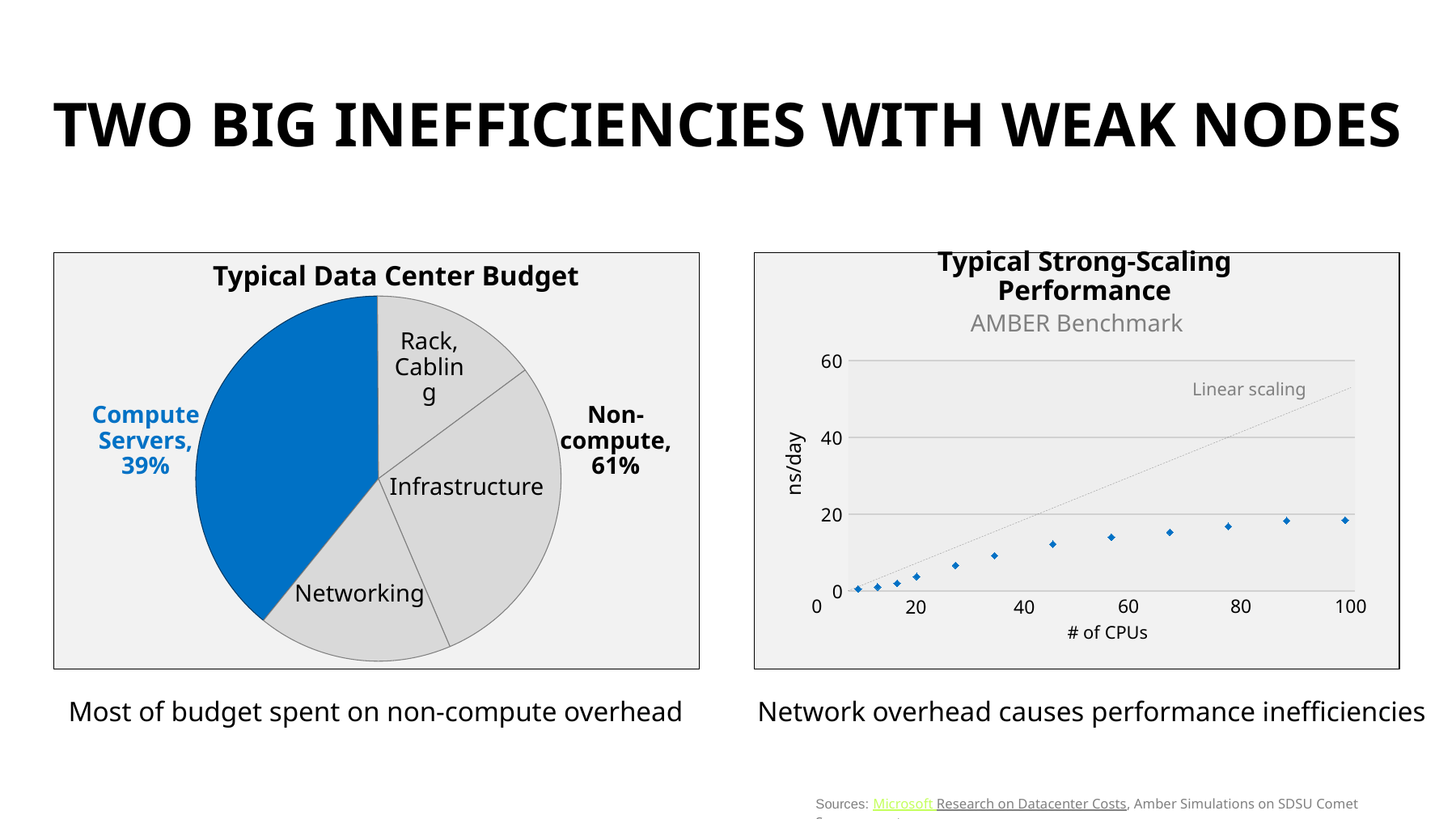
Which slice is the largest in the Typical Data Center Budget pie chart? Compute Servers What kind of chart is the Typical Data Center Budget chart? Pie chart In the Typical Data Center Budget pie chart, which slice is coloured blue? Compute Servers How many data points are plotted in the Typical Strong-Scaling Performance chart? 12 In the Typical Strong-Scaling Performance chart, what is the dashed reference line labelled? Linear scaling In the Typical Data Center Budget pie chart, what share of the budget goes to Compute Servers? 39% In the Typical Strong-Scaling Performance chart, do the ns/day values rise or fall as the number of CPUs increases? Rise In the Typical Data Center Budget pie chart, what share of the budget is labelled Non-compute? 61% In the Typical Strong-Scaling Performance chart, is the ns/day value at about 20 CPUs greater or less than 20? Less In the Typical Strong-Scaling Performance chart, is the ns/day value at about 60 CPUs greater or less than 20? Less How many slices does the Typical Data Center Budget pie chart have? 4 What kind of chart is the Typical Strong-Scaling Performance chart? Scatter chart